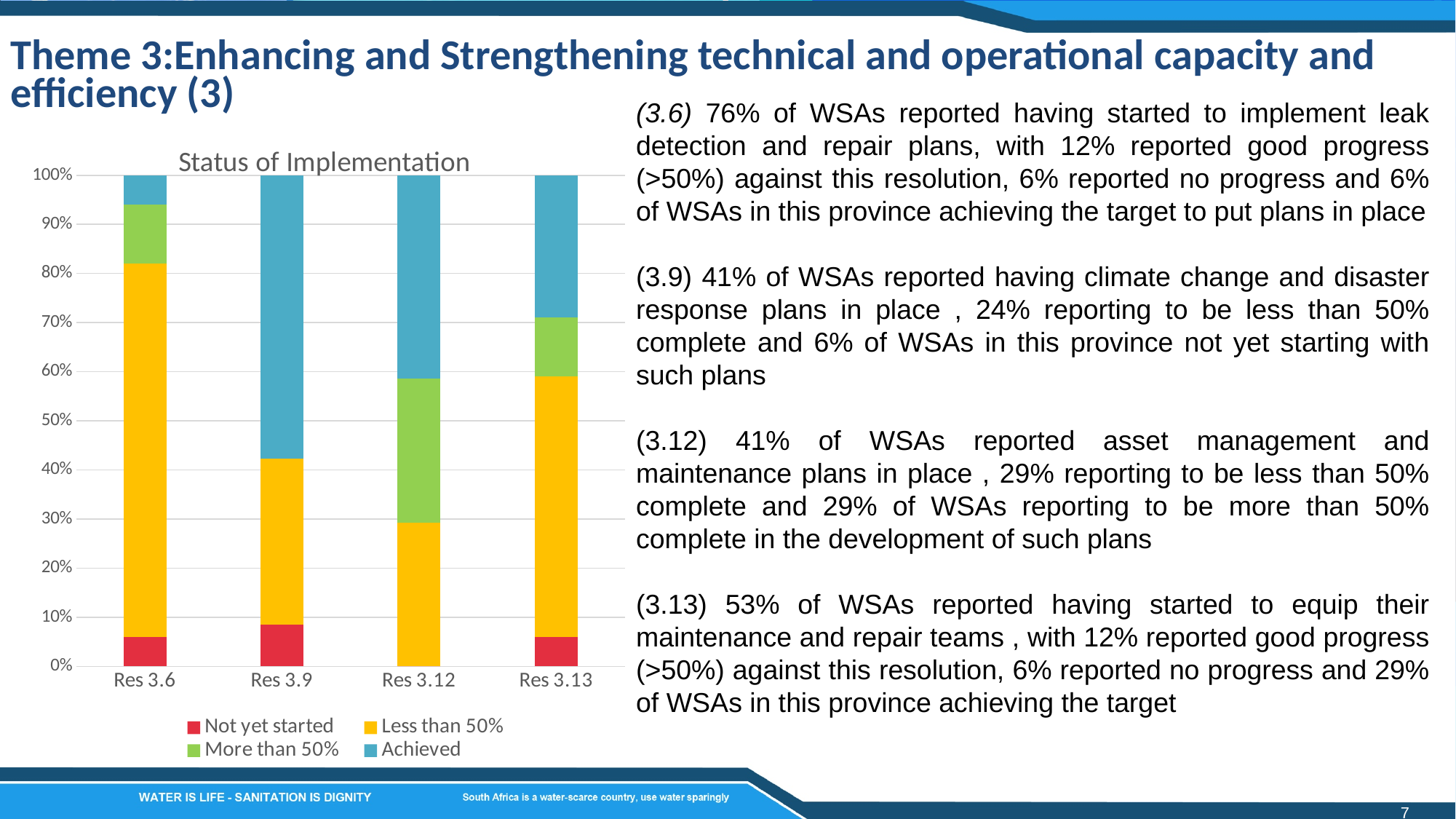
Is the 'Achieved' segment larger for Res 3.9 or for Res 3.13? Res 3.9 Which category has the smallest 'Achieved' segment? Res 3.6 What is the title of the chart? Status of Implementation Which category has the largest 'Less than 50%' segment? Res 3.6 Which colour represents the 'Achieved' series in the chart? Blue How many categories are shown on the x axis of the chart? 4 Which category has the largest 'Achieved' segment? Res 3.9 Which category has the largest 'More than 50%' segment? Res 3.12 What is the total height of the Res 3.6 stacked bar? 100% What kind of chart is shown on the slide? Stacked bar chart Is the 'Achieved' share for Res 3.9 greater or less than 50%? greater How many series does the chart legend list? 4